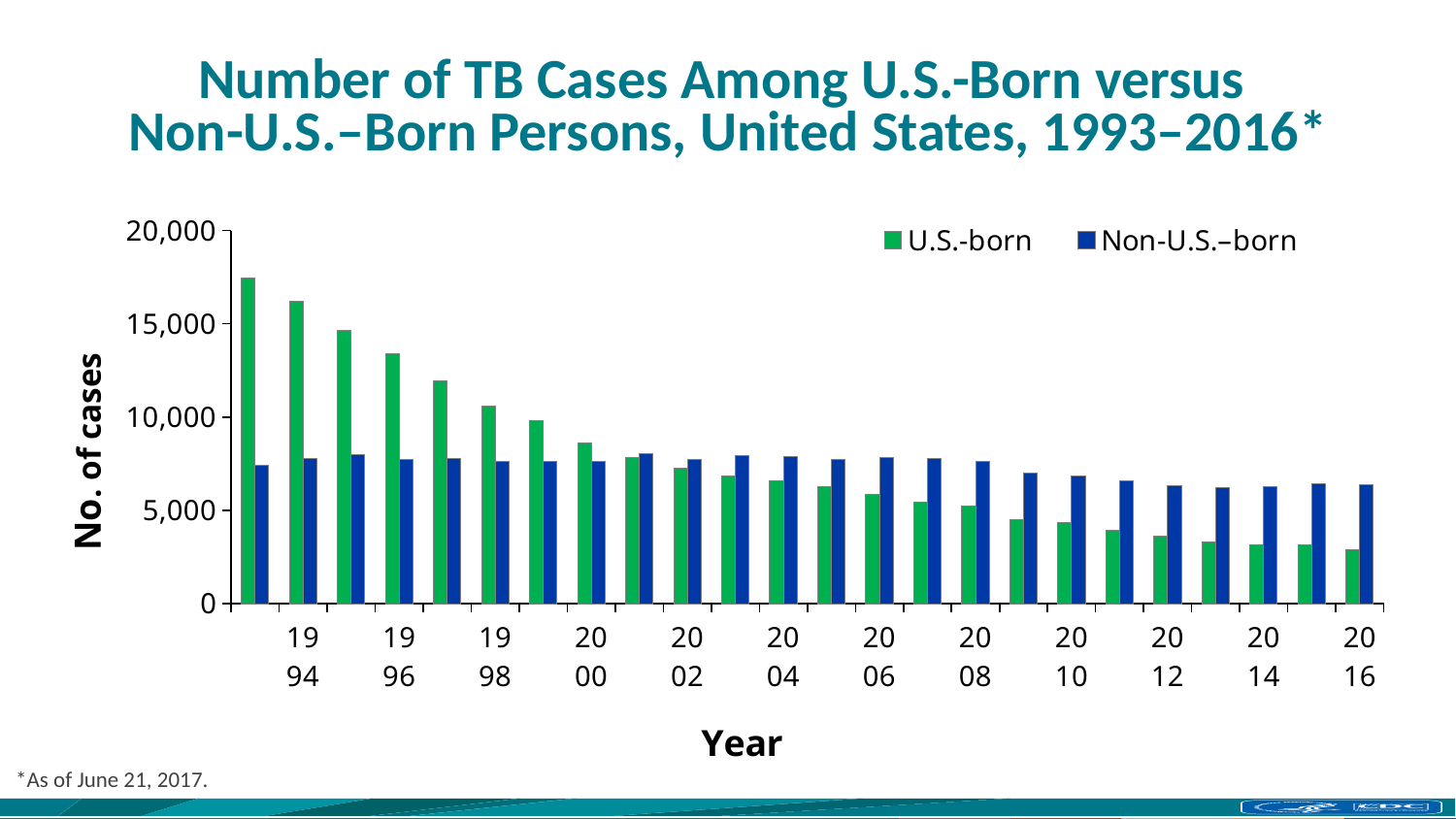
Is the U.S.-born value for 2000 greater or less than 10,000? less How many series does the legend list? 2 What are the two series named in the legend? U.S.-born and Non-U.S.–born Is the U.S.-born value for 1994 greater or less than 15,000? greater Is the U.S.-born value for 1996 greater or less than 15,000? less What kind of chart is shown on the slide? Bar chart What is the label on the vertical axis? No. of cases How many years are plotted on the chart? 24 In 1994, which is larger: the U.S.-born value or the Non-U.S.–born value? U.S.-born Do the U.S.-born values rise or fall from left to right across the years? Fall